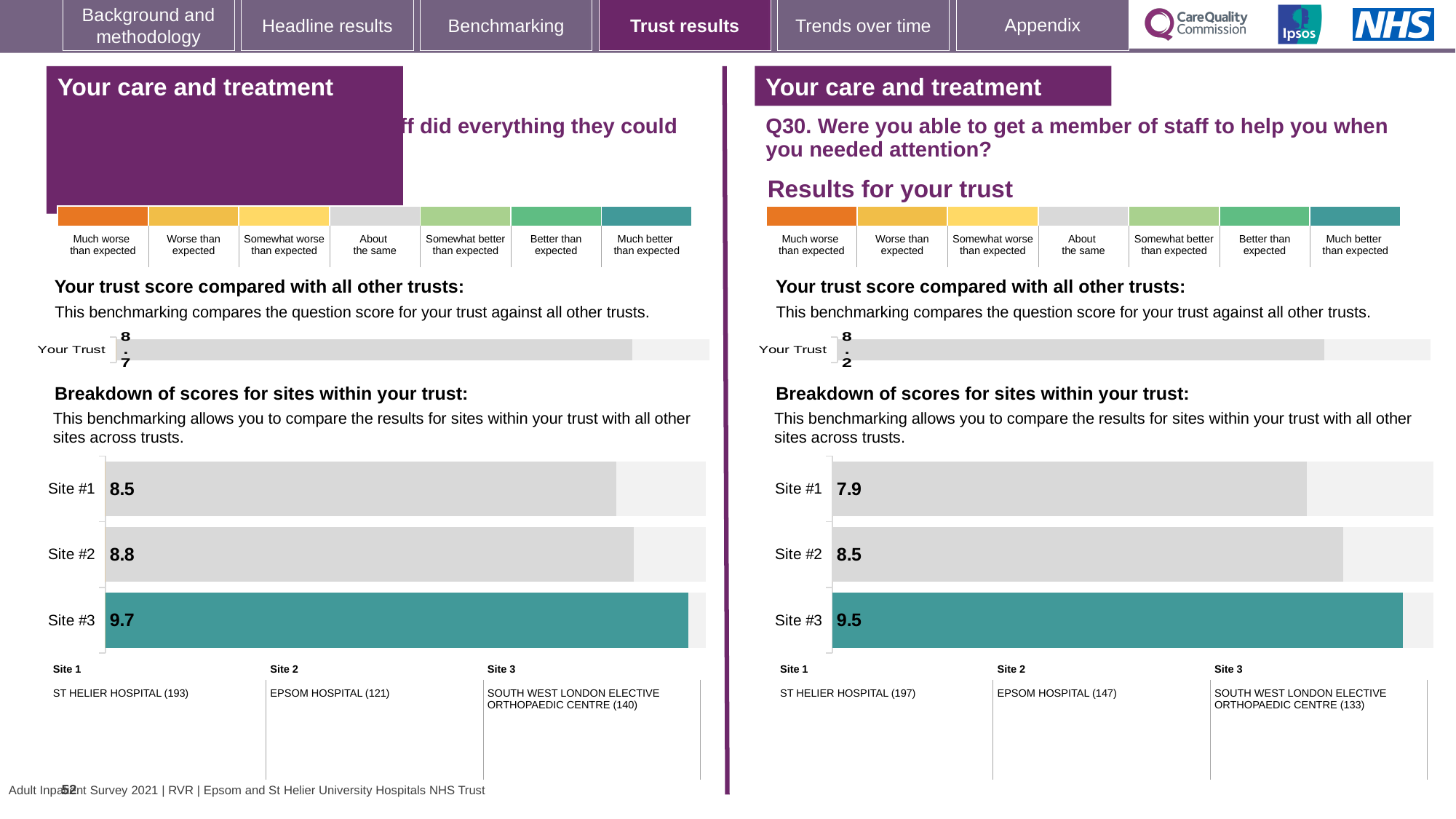
What type of chart is used for the site breakdown on the Q30 side of the slide? Bar chart Which is larger: the Site #1 score on the left-hand site breakdown chart or the Site #1 score on the Q30 site breakdown chart? The left-hand chart (8.5) On the left-hand site breakdown chart, which site has the highest score? Site #3 On the Q30 site breakdown chart, what is the difference between the scores for Site #3 and Site #2? 1.0 On the Q30 site breakdown chart, what is the score for Site #2? 8.5 On the left-hand site breakdown chart, what is the difference between the scores for Site #3 and Site #1? 1.2 On the Q30 'Your trust score compared with all other trusts' chart, what is the score for Your Trust? 8.2 On the left-hand site breakdown chart, what is the score for Site #1? 8.5 On the Q30 site breakdown chart, how many sites are shown? 3 On the Q30 site breakdown chart, which site has the lowest score? Site #1 On the left-hand 'Your trust score compared with all other trusts' chart, what is the score for Your Trust? 8.7 On the left-hand site breakdown chart, what is the score for Site #3? 9.7